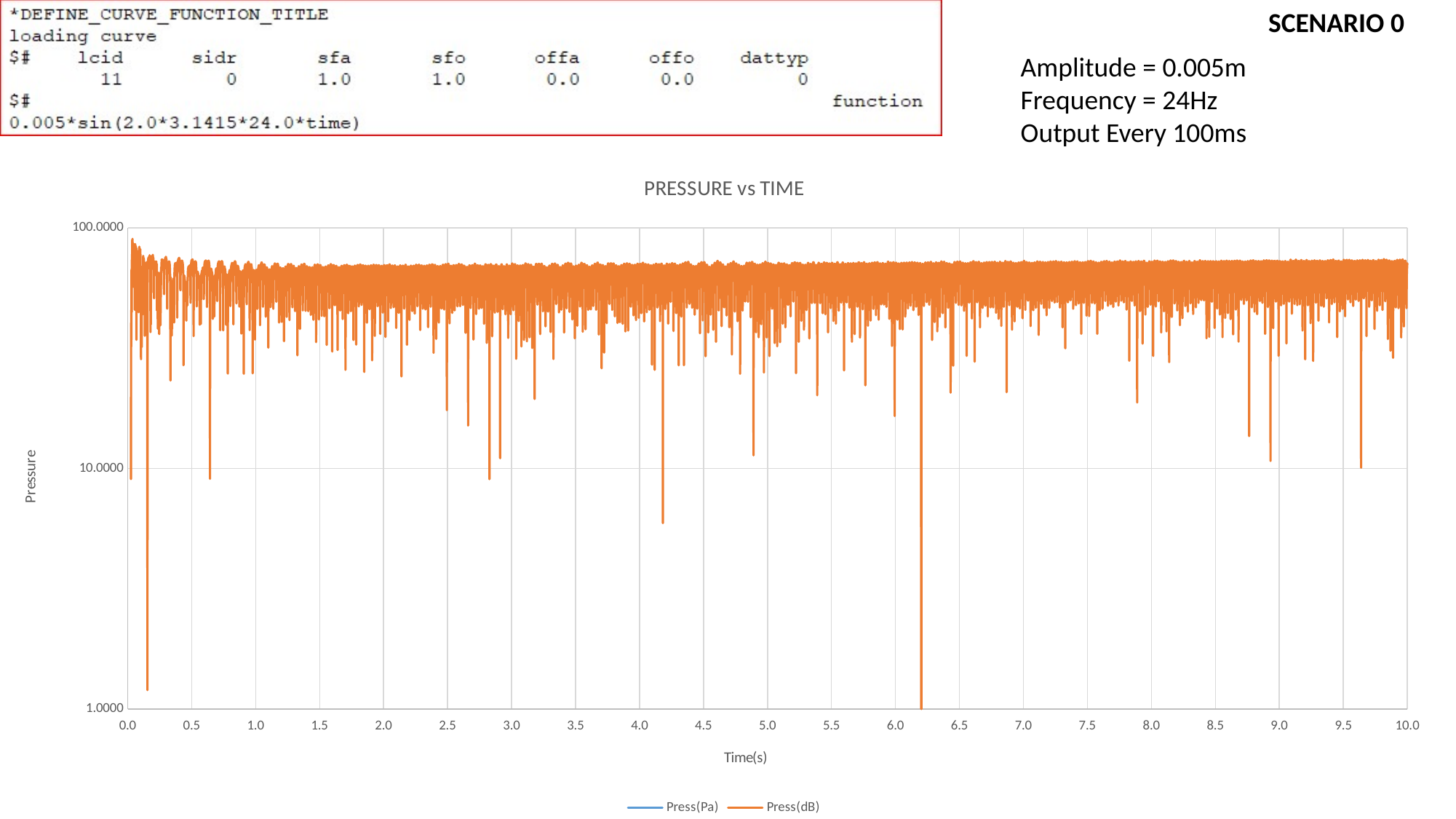
What are the two series named in the chart's legend? Press(Pa) and Press(dB) What is the label of the y axis of the PRESSURE vs TIME chart? Pressure Which colour is used for the Press(dB) series in the chart? orange What is the highest tick value shown on the y axis of the chart? 100.0000 What is the title of the chart on the slide? PRESSURE vs TIME What is the label of the x axis of the PRESSURE vs TIME chart? Time(s) What is the lowest tick value shown on the y axis of the chart? 1.0000 What kind of chart is shown under the title PRESSURE vs TIME? line chart How many series does the chart's legend list? 2 How many tick labels are shown along the x axis of the chart? 21 What is the largest time value shown on the x axis of the chart? 10.0